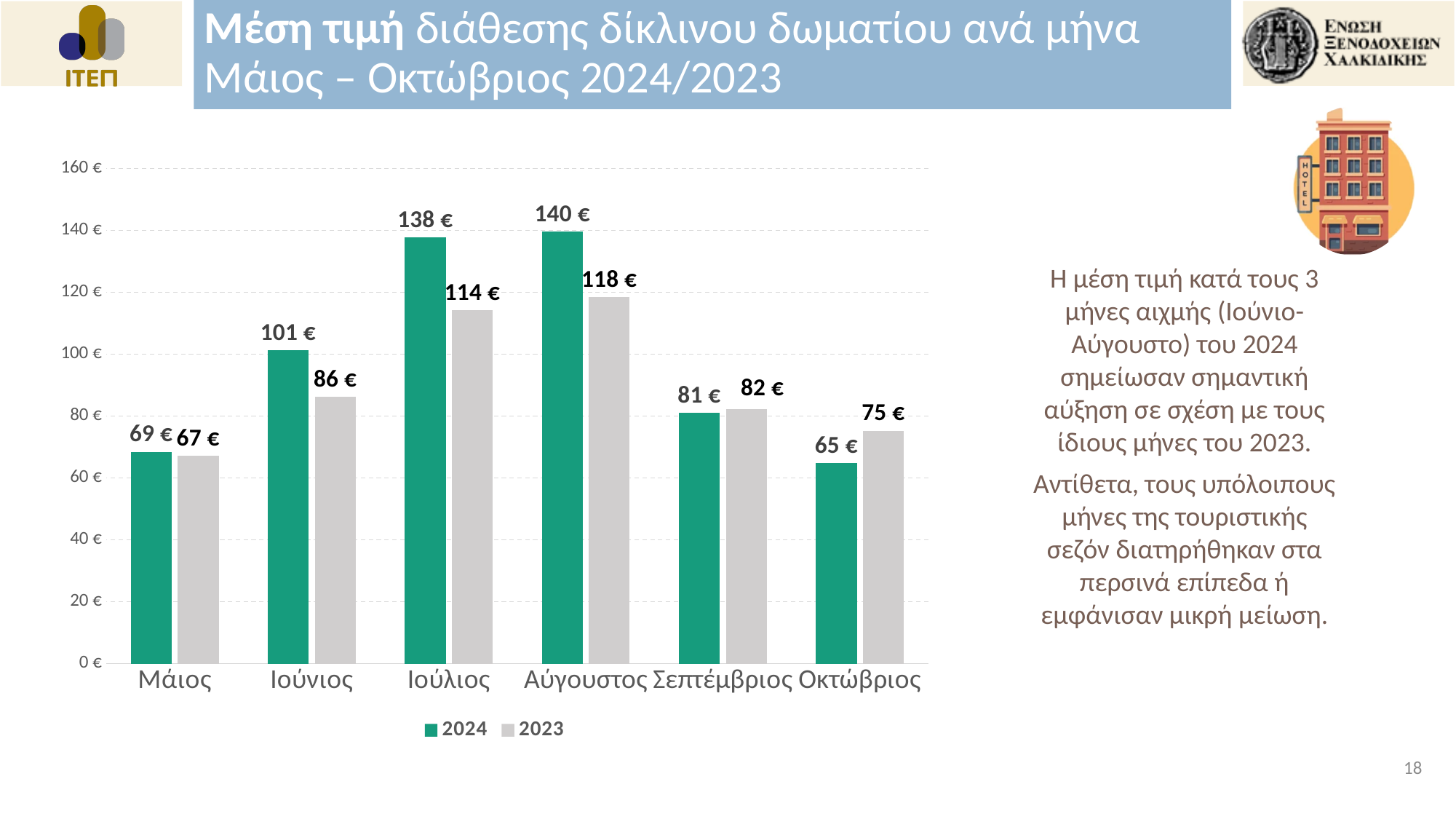
What is the difference between the 2024 and 2023 values for Ιούνιος? 15 € What is the value for Σεπτέμβριος in the 2023 series? 82 € Which month has the lowest value in the 2023 series? Μάιος What is the value for Ιούλιος in the 2024 series? 138 € How many months are shown on the x axis? 6 Which colour represents the 2024 series in the legend? Green How many series does the legend list? 2 What is the value for Οκτώβριος in the 2024 series? 65 € What kind of chart is shown on the slide? Bar chart Which month has the highest value in the 2024 series? Αύγουστος What is the difference between the 2024 and 2023 values for Αύγουστος? 22 € Which is larger for Οκτώβριος, the 2024 value or the 2023 value? 2023